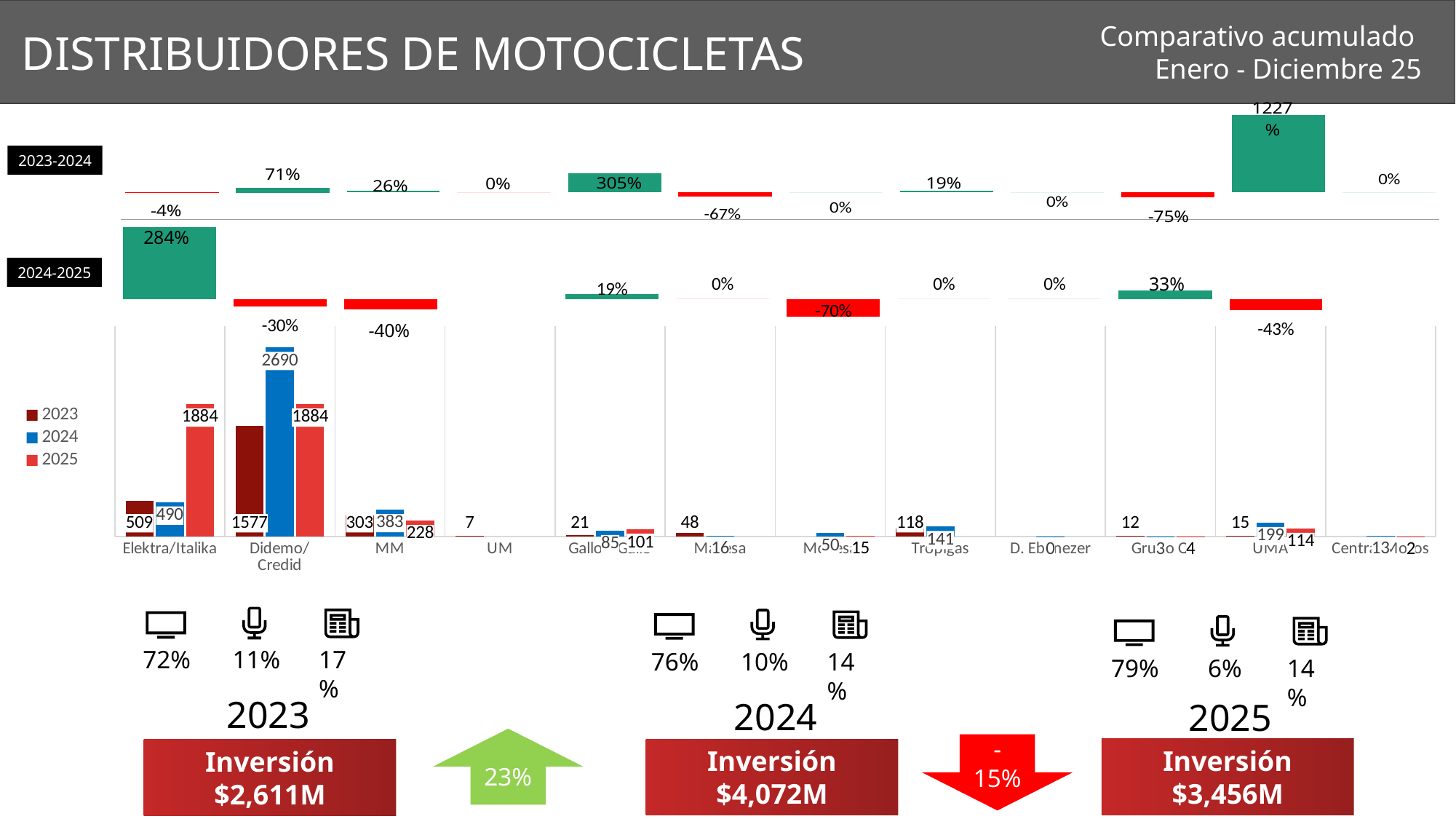
In the 2023-2024 chart at the top, what is the value shown for UMA? 1227% In the bottom bar chart, what is the 2024 value for Didemo/Credid? 2690 In the 2023-2024 chart at the top, which distributor has the highest value? UMA In the bottom bar chart, what is the 2025 value for Elektra/Italika? 1884 How many series does the legend of the bottom chart list? 3 What kind of chart is the bottom chart with the 2023, 2024 and 2025 series? Bar chart In the bottom bar chart, which is larger for Elektra/Italika: the 2024 value or the 2025 value? 2025 In the bottom bar chart, which distributor has the highest 2024 value? Didemo/Credid In the bottom bar chart, what is the difference between the 2024 and 2023 values for Didemo/Credid? 1113 In the 2024-2025 chart, what is the value shown for Elektra/Italika? 284% In the bottom bar chart, what is the 2024 value for UMA? 199 In the bottom bar chart, what is the 2023 value for MM? 303